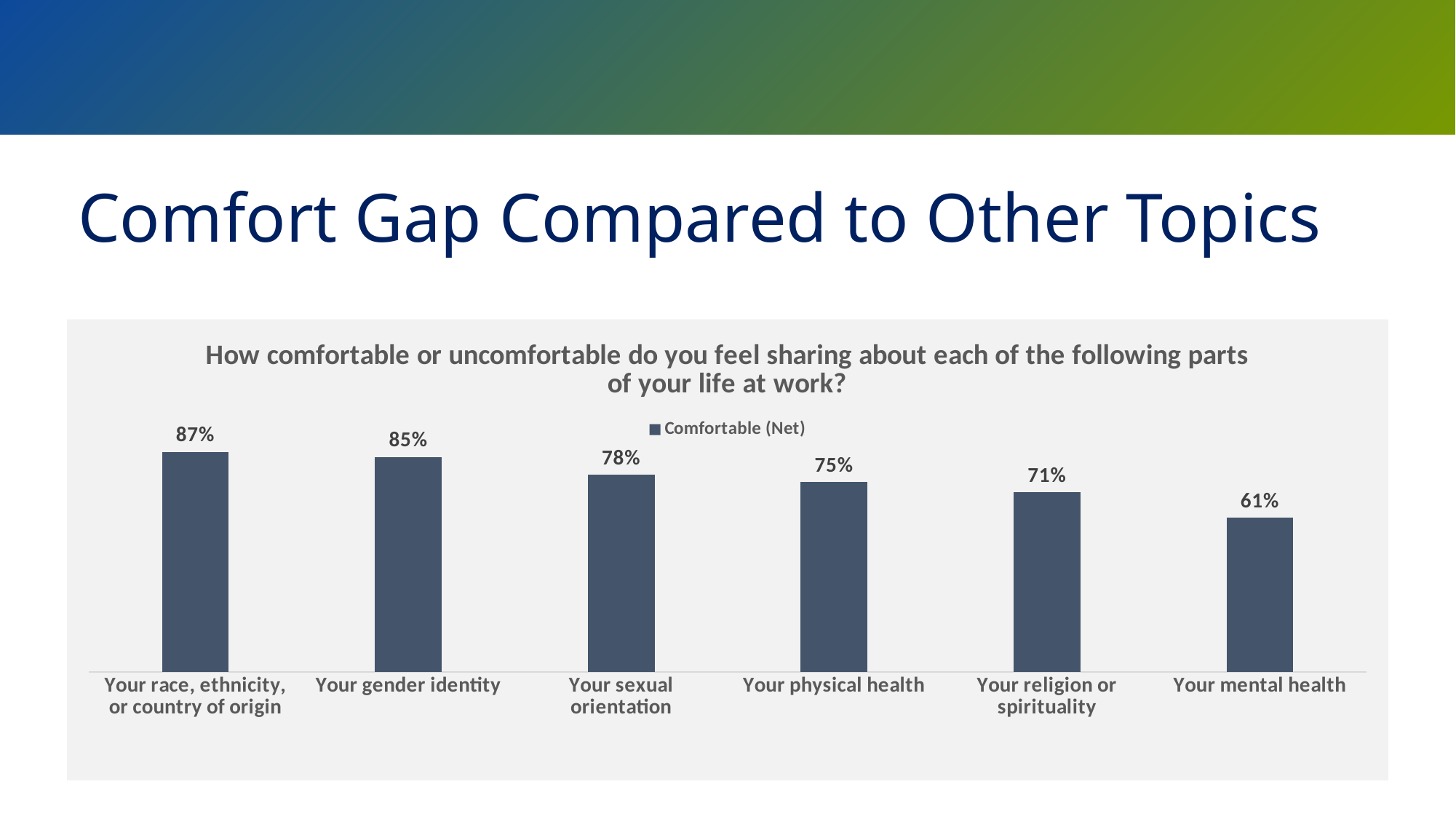
Which has a higher Comfortable (Net) value, Your physical health or Your mental health? Your physical health Do the Comfortable (Net) values rise or fall from left to right across the categories? Fall What is the difference between the Comfortable (Net) values for Your race, ethnicity, or country of origin and Your mental health? 26% Which category has the highest Comfortable (Net) value? Your race, ethnicity, or country of origin What is the Comfortable (Net) value for Your mental health? 61% How many categories are shown in the chart? 6 What kind of chart is shown on the slide? Bar chart What is the difference between the Comfortable (Net) values for Your sexual orientation and Your physical health? 3% Which category has the lowest Comfortable (Net) value? Your mental health What is the Comfortable (Net) value for Your gender identity? 85% What is the Comfortable (Net) value for Your religion or spirituality? 71% How many series does the legend list? 1